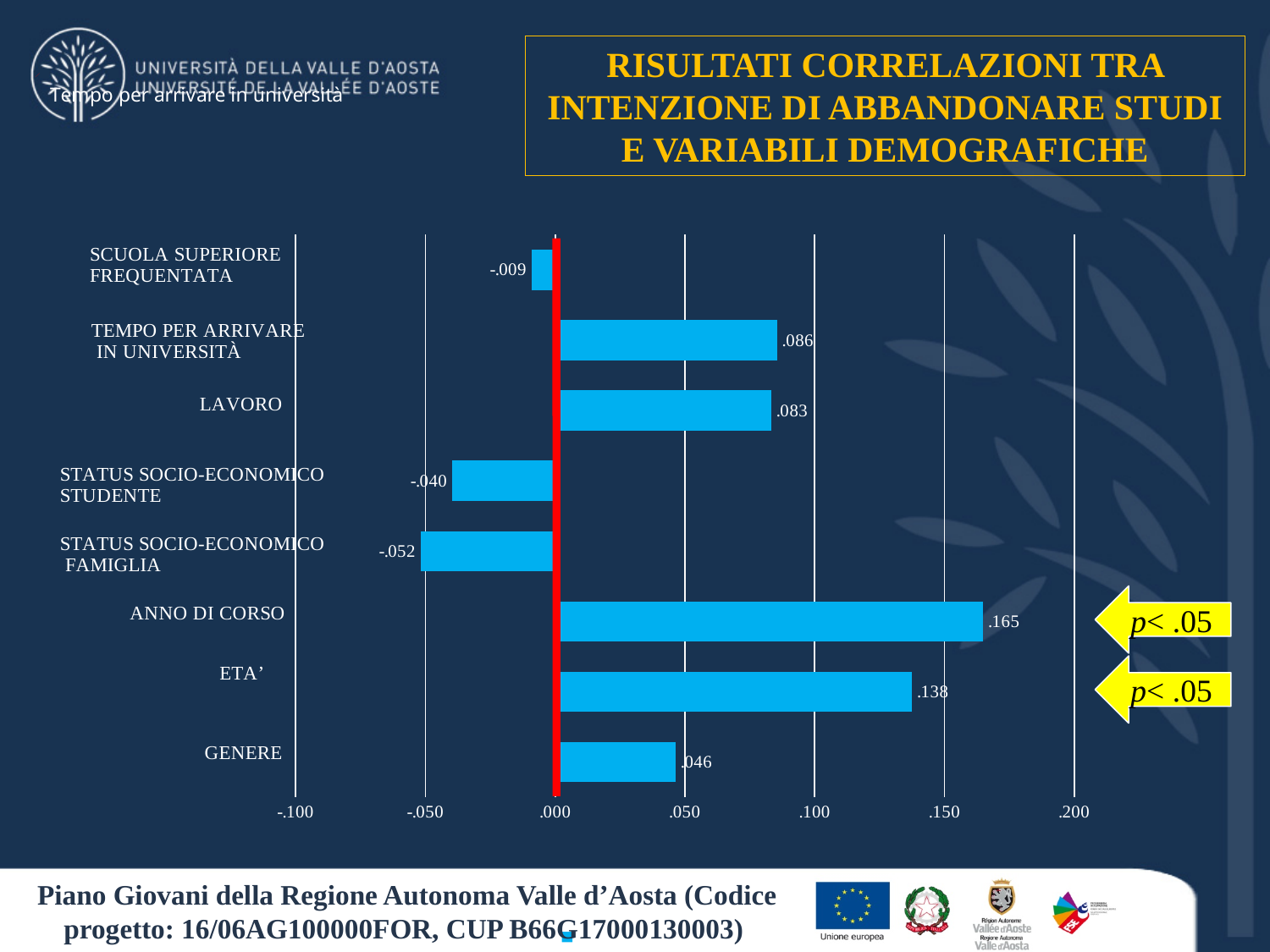
How many categories have negative values in the chart? 3 Is the value for ETA' greater or less than .100? greater What is the value shown for SCUOLA SUPERIORE FREQUENTATA? -.009 Which category has the lowest value in the chart? STATUS SOCIO-ECONOMICO FAMIGLIA What is the value shown for GENERE? .046 What kind of chart is shown on the slide? Bar chart What is the correlation value shown for ANNO DI CORSO? .165 How many categories are plotted in the chart? 8 Which category has the highest value in the chart? ANNO DI CORSO What is the difference between the values for ANNO DI CORSO and ETA'? .027 Which has a larger value, TEMPO PER ARRIVARE IN UNIVERSITÀ or GENERE? TEMPO PER ARRIVARE IN UNIVERSITÀ What is the value shown for STATUS SOCIO-ECONOMICO FAMIGLIA? -.052